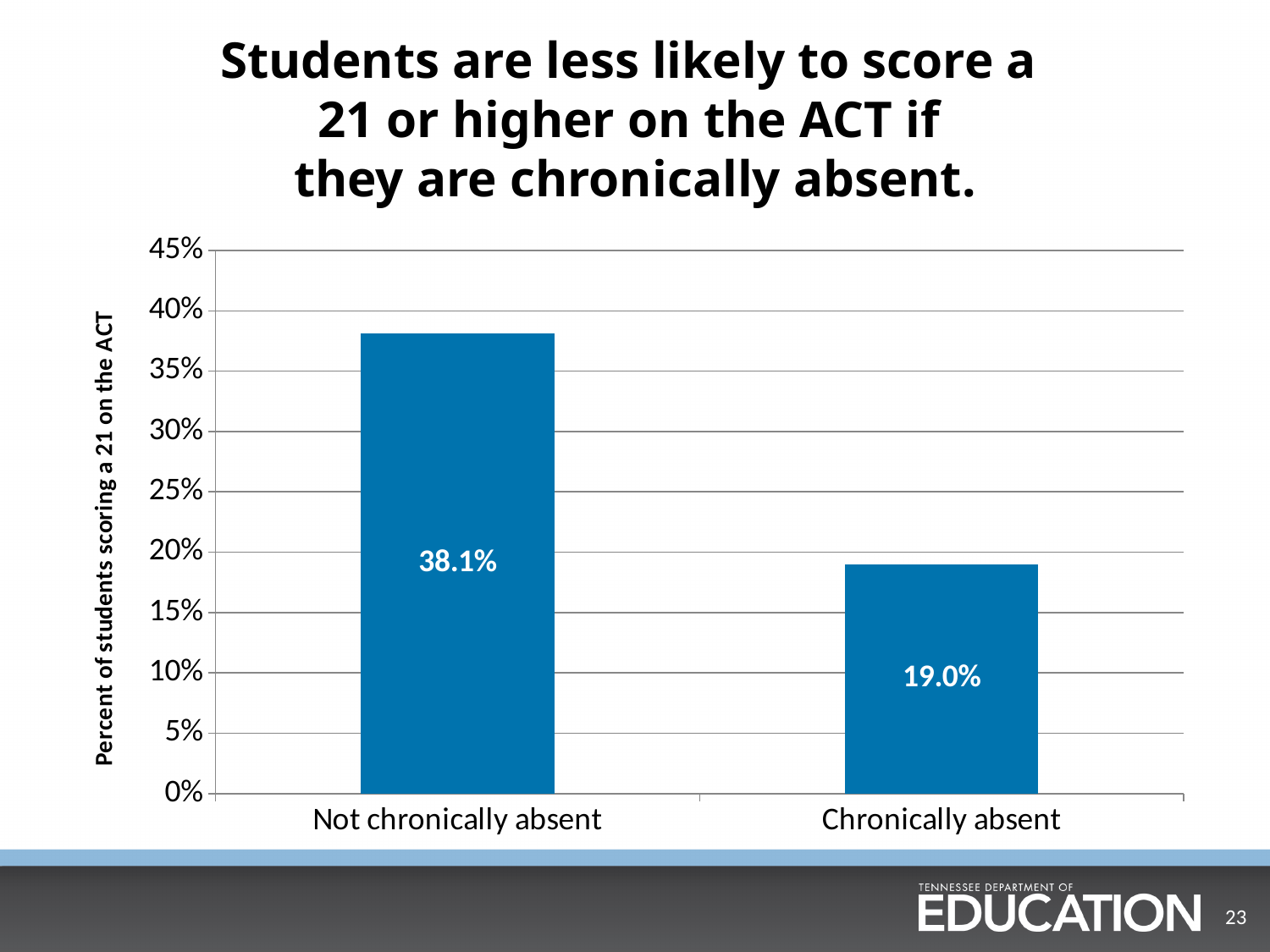
Which category has the lower percent of students scoring a 21 on the ACT? Chronically absent What is the label of the vertical axis? Percent of students scoring a 21 on the ACT What is the highest value shown on the vertical axis? 45% How many categories are shown on the x axis of the chart? 2 Is the value for Not chronically absent greater or less than 35%? greater Is the value for Chronically absent greater or less than 20%? less Is the value for Not chronically absent larger or smaller than the value for Chronically absent? larger What is the difference in percentage points between the not chronically absent and chronically absent bars? 19.1 What kind of chart is shown on the slide? Bar chart What percent of students who are not chronically absent scored a 21 on the ACT? 38.1% What percent of chronically absent students scored a 21 on the ACT? 19.0% Which category has the higher percent of students scoring a 21 on the ACT? Not chronically absent